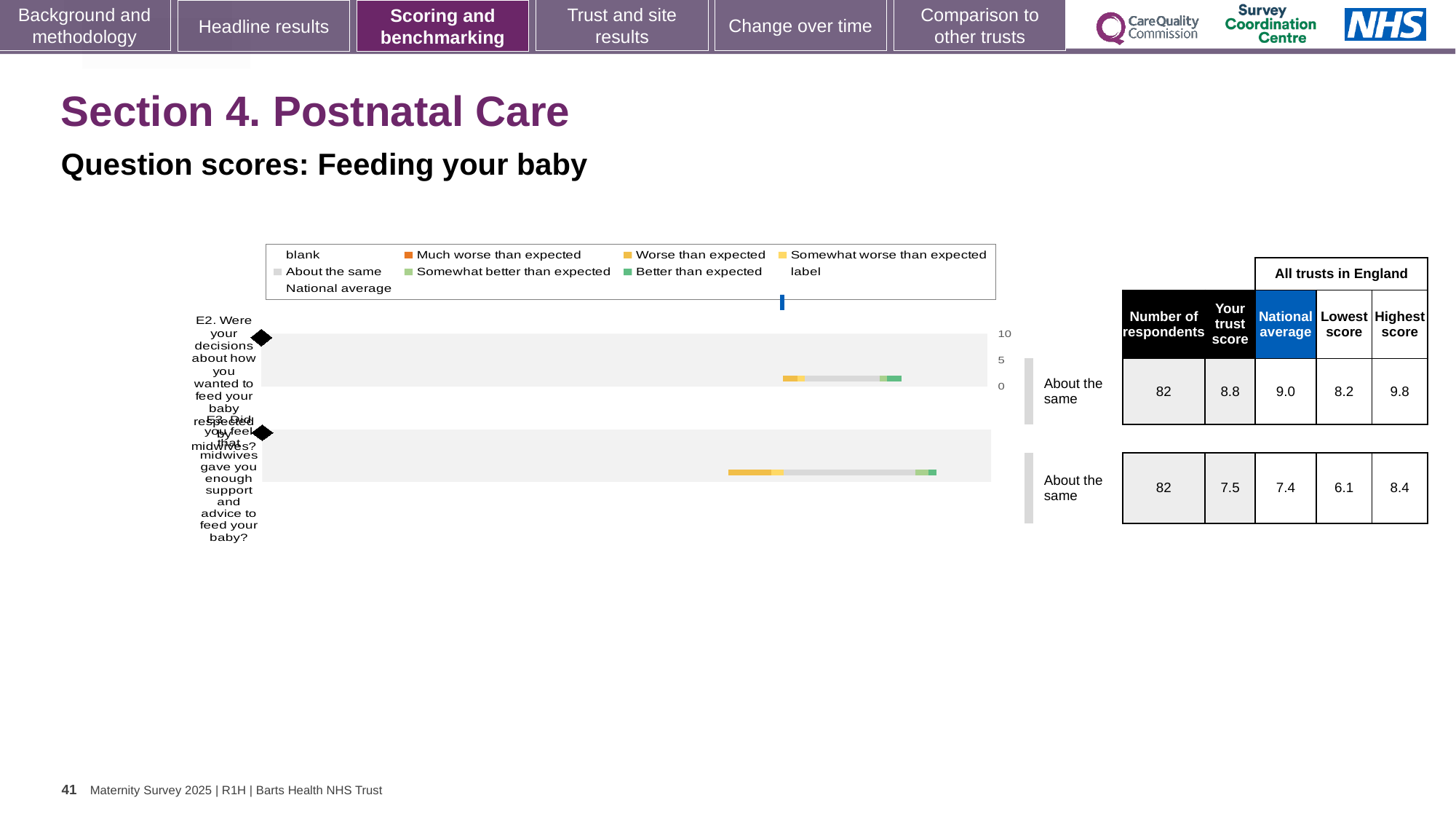
What benchmark category is shown for question E3 in the Feeding your baby chart? About the same For question E2, which is larger: the trust score or the national average? national average What is the national average for question E3 about midwives giving enough support and advice to feed your baby? 7.4 How many respondents answered question E2? 82 What kind of chart is used to show the question scores for Feeding your baby? bar chart What is the difference between the highest and lowest scores for question E3? 2.3 What is the trust score for question E2 about decisions on how you wanted to feed your baby being respected by midwives? 8.8 How many questions (categories) are plotted in the Feeding your baby chart? 2 For question E3, which is larger: the trust score or the national average? trust score What is the lowest score among all trusts in England for question E3? 6.1 What is the highest score among all trusts in England for question E2? 9.8 What is the difference between the highest and lowest scores for question E2? 1.6